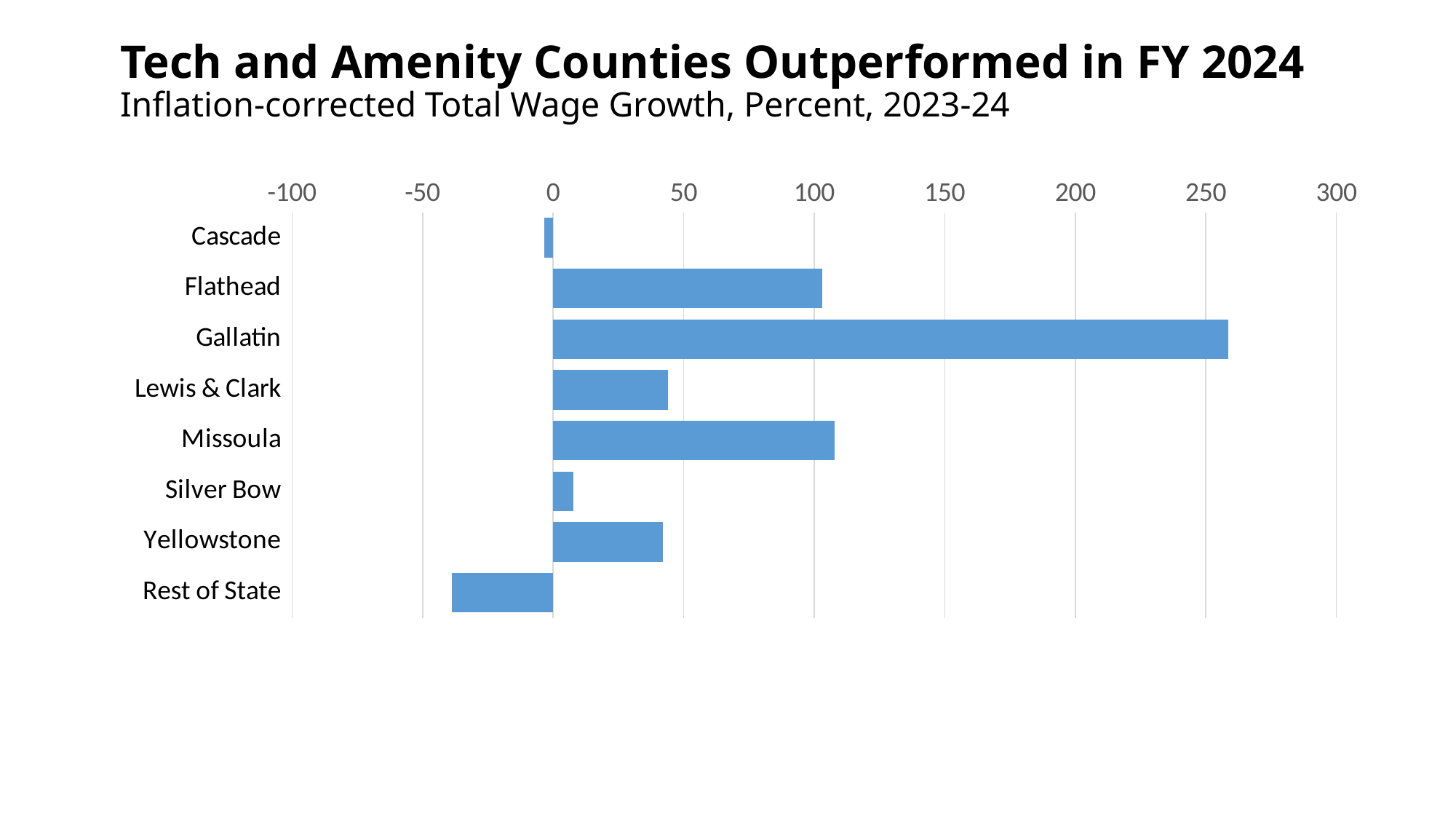
Is the value for Gallatin greater or less than 250? greater What is the title of the chart? Tech and Amenity Counties Outperformed in FY 2024 Which has the larger wage growth, Gallatin or Flathead? Gallatin How many counties or regions are plotted on the chart? 8 Which category has the lowest inflation-corrected total wage growth? Rest of State Is the value for Rest of State greater or less than 0? less What kind of chart is shown on the slide? bar chart Is the value for Flathead greater or less than 100? greater Which has the larger wage growth, Lewis & Clark or Silver Bow? Lewis & Clark Which category has the highest inflation-corrected total wage growth? Gallatin